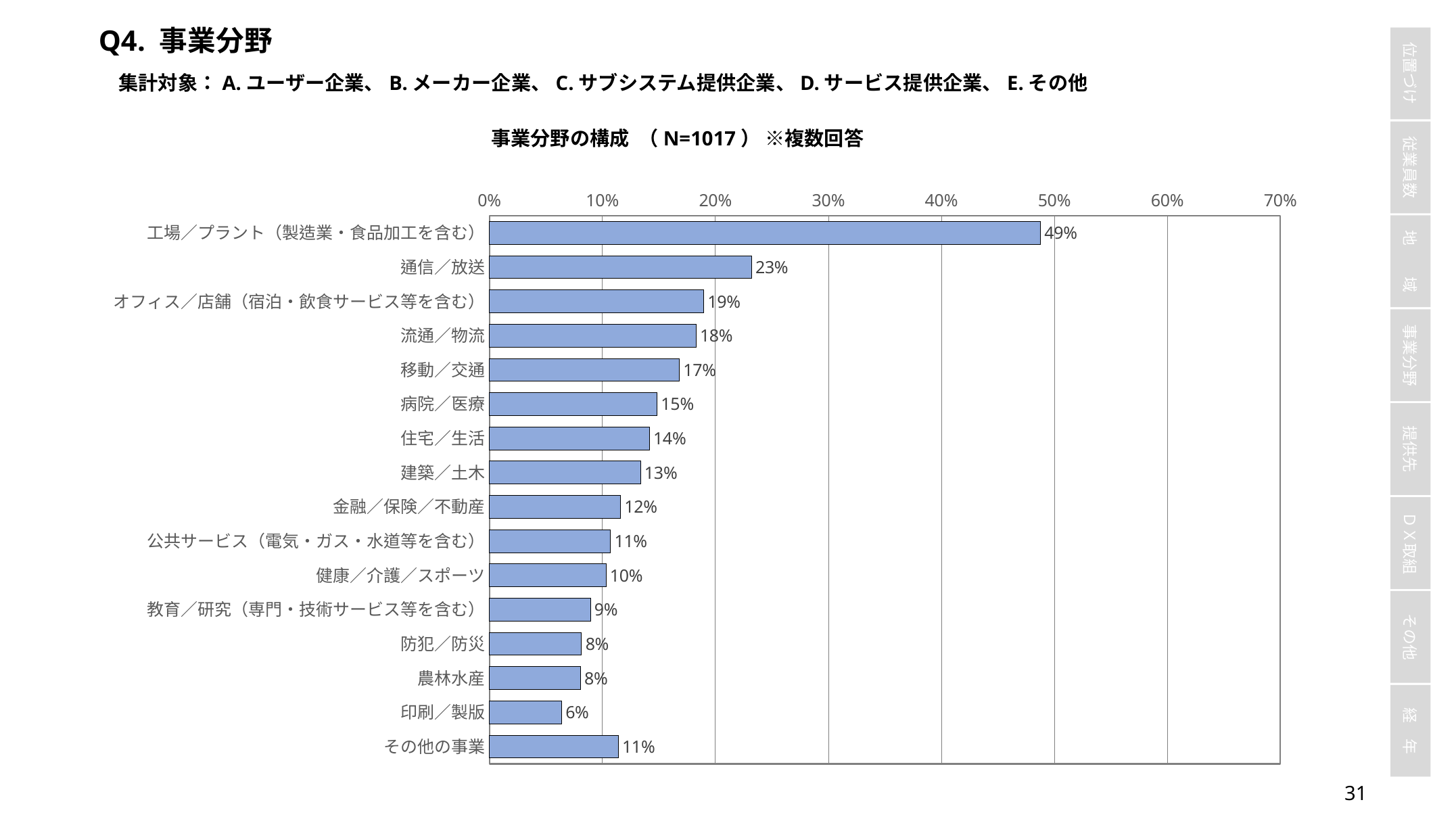
Which is larger, the value for 流通／物流 or the value for 移動／交通? 流通／物流 Is the value for 病院／医療 greater or less than 20%? less What kind of chart is shown on the slide? bar chart How many categories are shown in the chart? 16 What is the value for 通信／放送? 23% What is the N value shown in the chart title? N=1017 What is the difference between the values for 工場／プラント（製造業・食品加工を含む） and 通信／放送? 26% What is the value for 印刷／製版? 6% What is the value for その他の事業? 11% Which category has the lowest value? 印刷／製版 What is the value for 工場／プラント（製造業・食品加工を含む）? 49% Which category has the highest value? 工場／プラント（製造業・食品加工を含む）